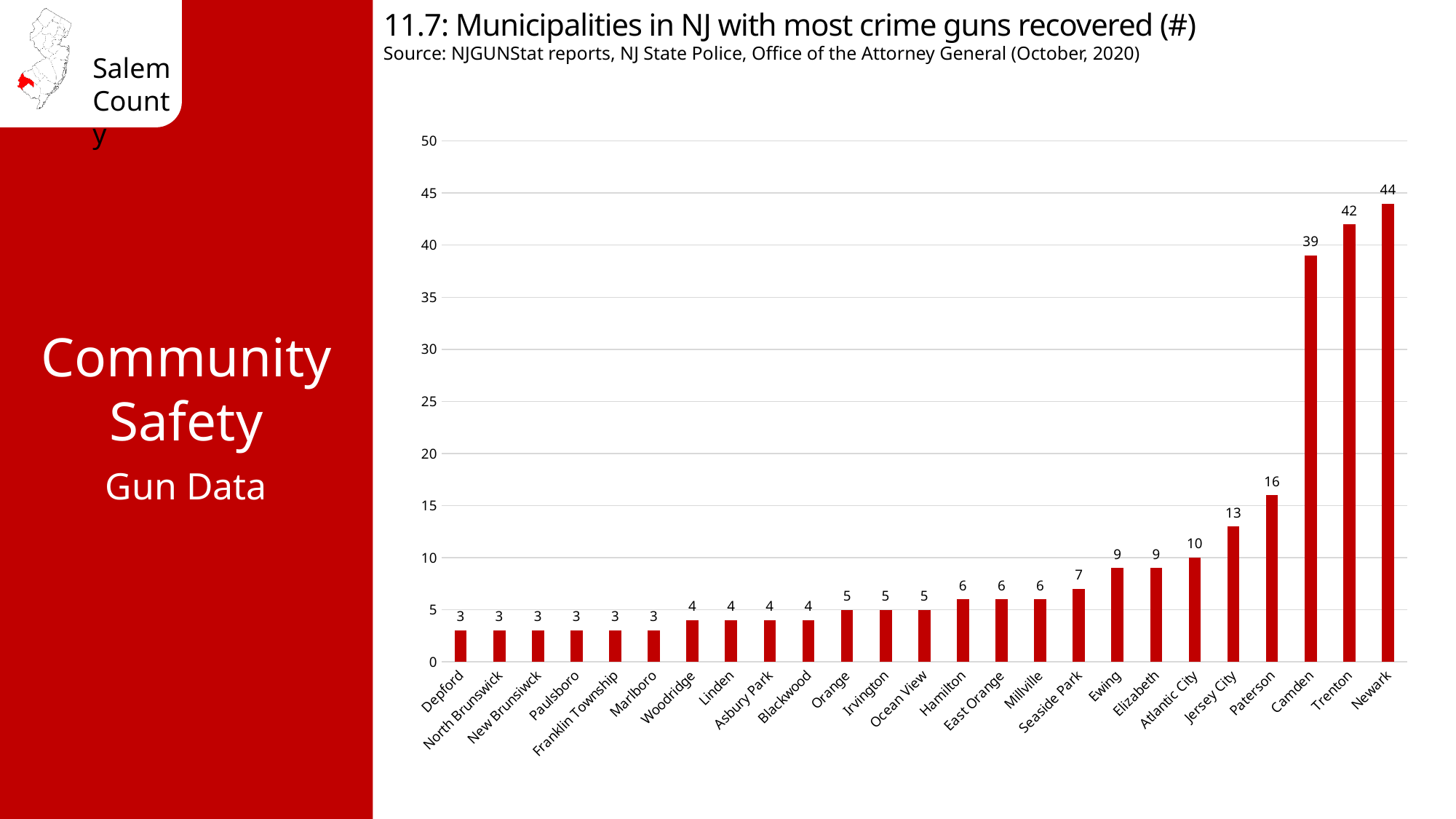
Which municipality has the highest number of crime guns recovered? Newark What is the difference between the number of crime guns recovered in Newark and in Trenton? 2 How many crime guns were recovered in Camden? 39 Is the value for Trenton greater or less than 40? greater What is the source cited for the chart? NJGUNStat reports, NJ State Police, Office of the Attorney General (October, 2020) How many municipalities are shown on the chart? 25 How many crime guns were recovered in Atlantic City? 10 What kind of chart is shown on the slide? bar chart Which has more crime guns recovered, Jersey City or Elizabeth? Jersey City Do the values generally rise or fall moving from left to right along the x axis? rise How many crime guns were recovered in Paterson? 16 What is the difference between the number of crime guns recovered in Camden and in Paterson? 23